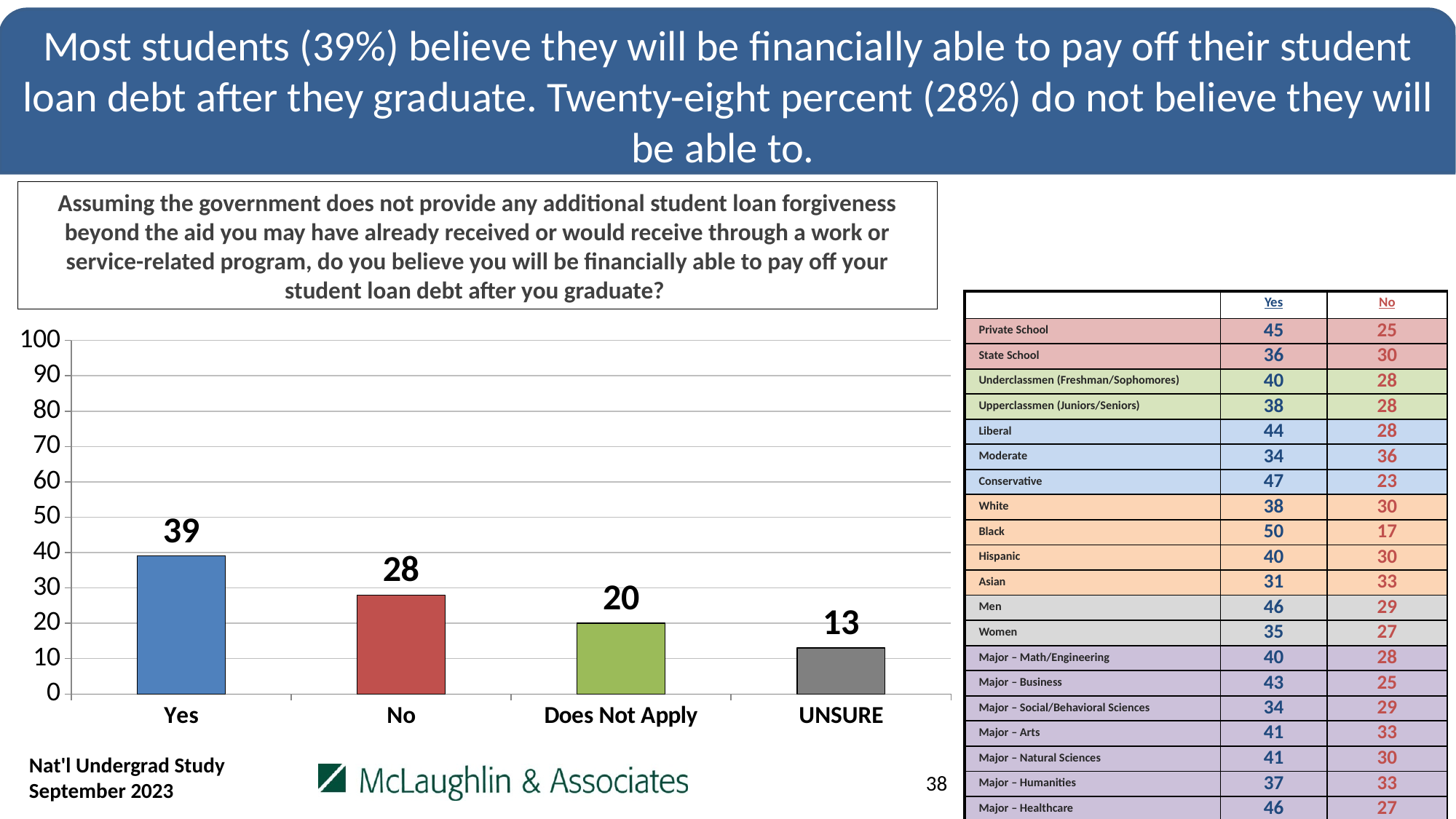
Which category has the lowest value? UNSURE Which category has the highest value? Yes Is the value for Yes greater or less than 50? less Which is larger, the value for No or the value for Does Not Apply? No How many categories are shown on the x axis? 4 Do the values rise or fall from left to right along the x axis? fall What is the difference between the values for Yes and No? 11 What is the value for Does Not Apply? 20 What kind of chart is this? bar chart What is the value for UNSURE? 13 What is the value for No? 28 What is the value for Yes? 39